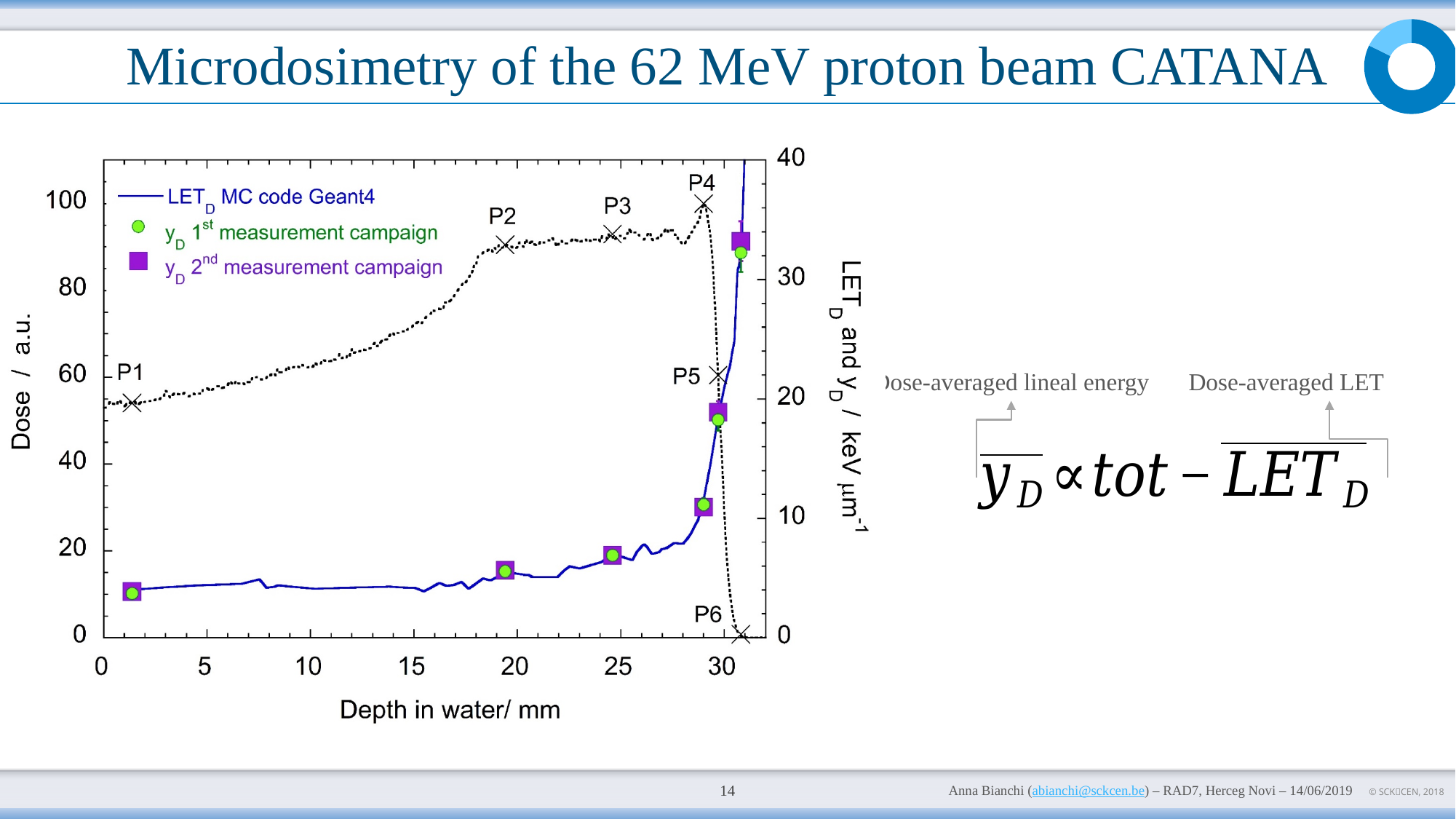
Is the dose at P4 greater or less than 80? greater What is the left y-axis title of the chart? Dose / a.u. How many labeled points (P1 to P6) are marked on the dose curve? 6 Is the dose at P1 greater or less than 60? less Which labeled point (P1–P6) has the lowest dose? P6 Which has the larger dose, P3 or P5? P3 Does the LET_D MC code Geant4 curve rise or fall as depth in water increases? rise Is the dose at P6 greater or less than 20? less What kind of chart is shown on the slide? line chart Which labeled point (P1–P6) has the highest dose? P4 How many entries does the chart legend list? 3 What is the x-axis title of the chart? Depth in water/ mm